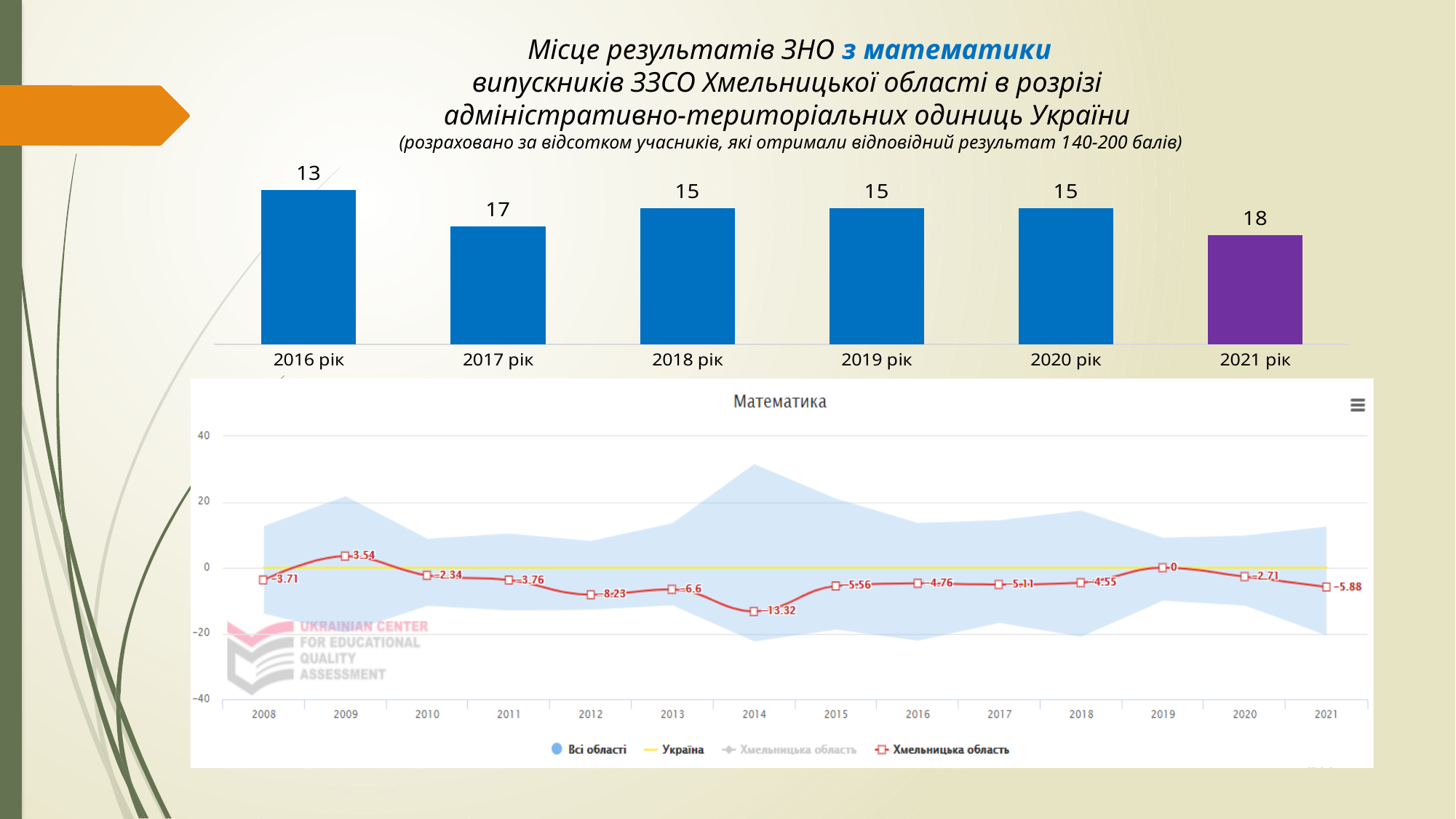
In the bottom chart titled Математика, what is the value for Хмельницька область in 2014? -13.32 How many years are shown in the top bar chart? 6 How many entries does the legend of the bottom chart titled Математика list? 4 In the bottom chart titled Математика, which is larger: the Хмельницька область value in 2019 or in 2021? 2019 What kind of chart is the top chart on the slide? bar chart In the bottom chart titled Математика, in which year is the Хмельницька область value lowest? 2014 In the top bar chart, what is the value for 2021 рік? 18 In the top bar chart, what is the difference between the values for 2017 рік and 2016 рік? 4 In the top bar chart, what is the value for 2016 рік? 13 In the bottom chart titled Математика, what is the value for Хмельницька область in 2009? 3.54